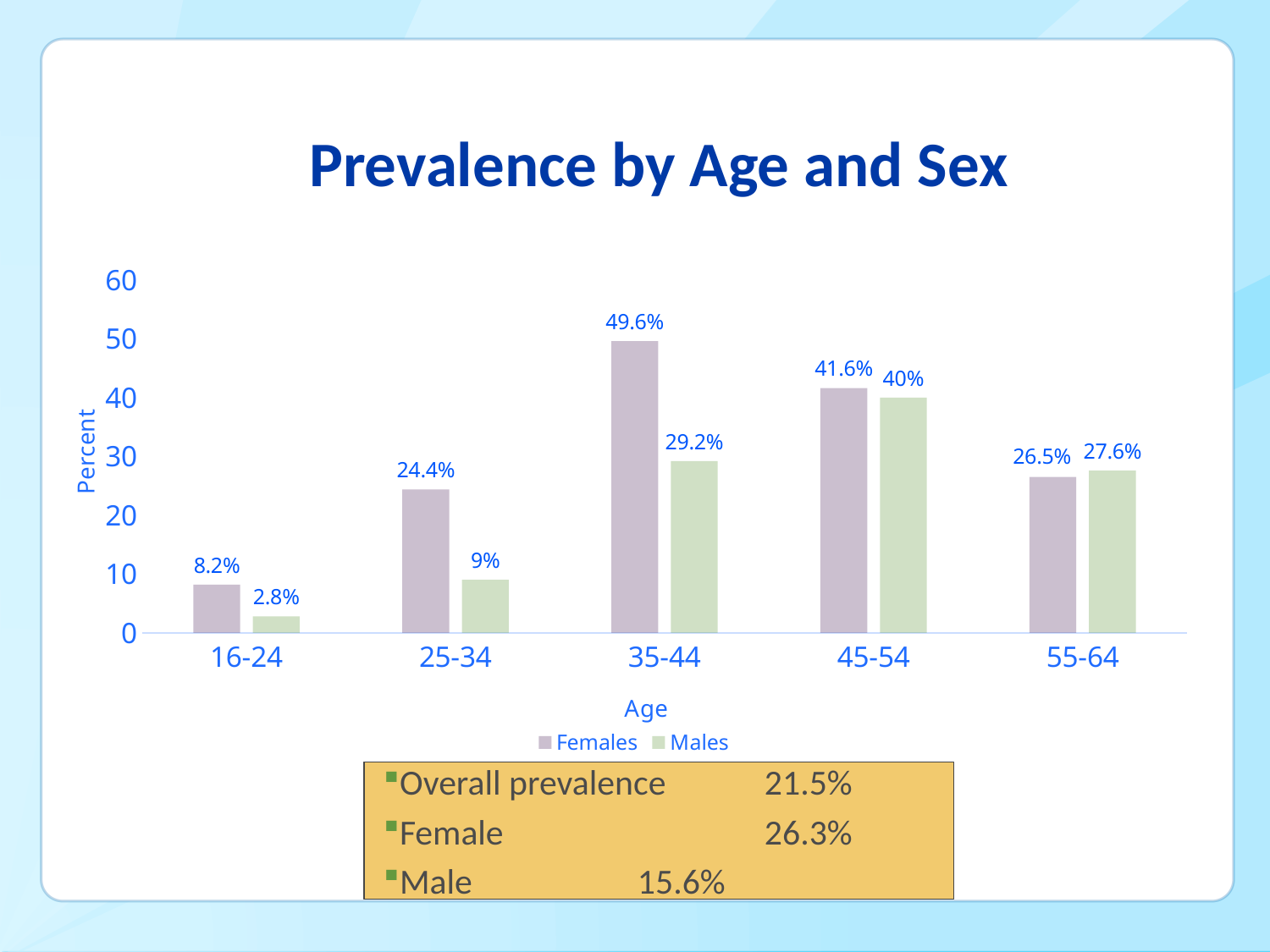
What is the difference between the Females and Males values in the 35-44 age group? 20.4% What is the prevalence for Males in the 16-24 age group? 2.8% How many series does the legend list? 2 Which age group has the highest prevalence for Females? 35-44 In the 55-64 age group, which is larger, the Females value or the Males value? Males How many age groups are shown on the x axis? 5 What is the title of the chart? Prevalence by Age and Sex Which age group has the lowest prevalence for Males? 16-24 What kind of chart is shown on the slide? Bar chart Is the Females value for the 25-34 age group greater or less than 20? greater What is the prevalence for Females in the 35-44 age group? 49.6% What is the prevalence for Males in the 45-54 age group? 40%